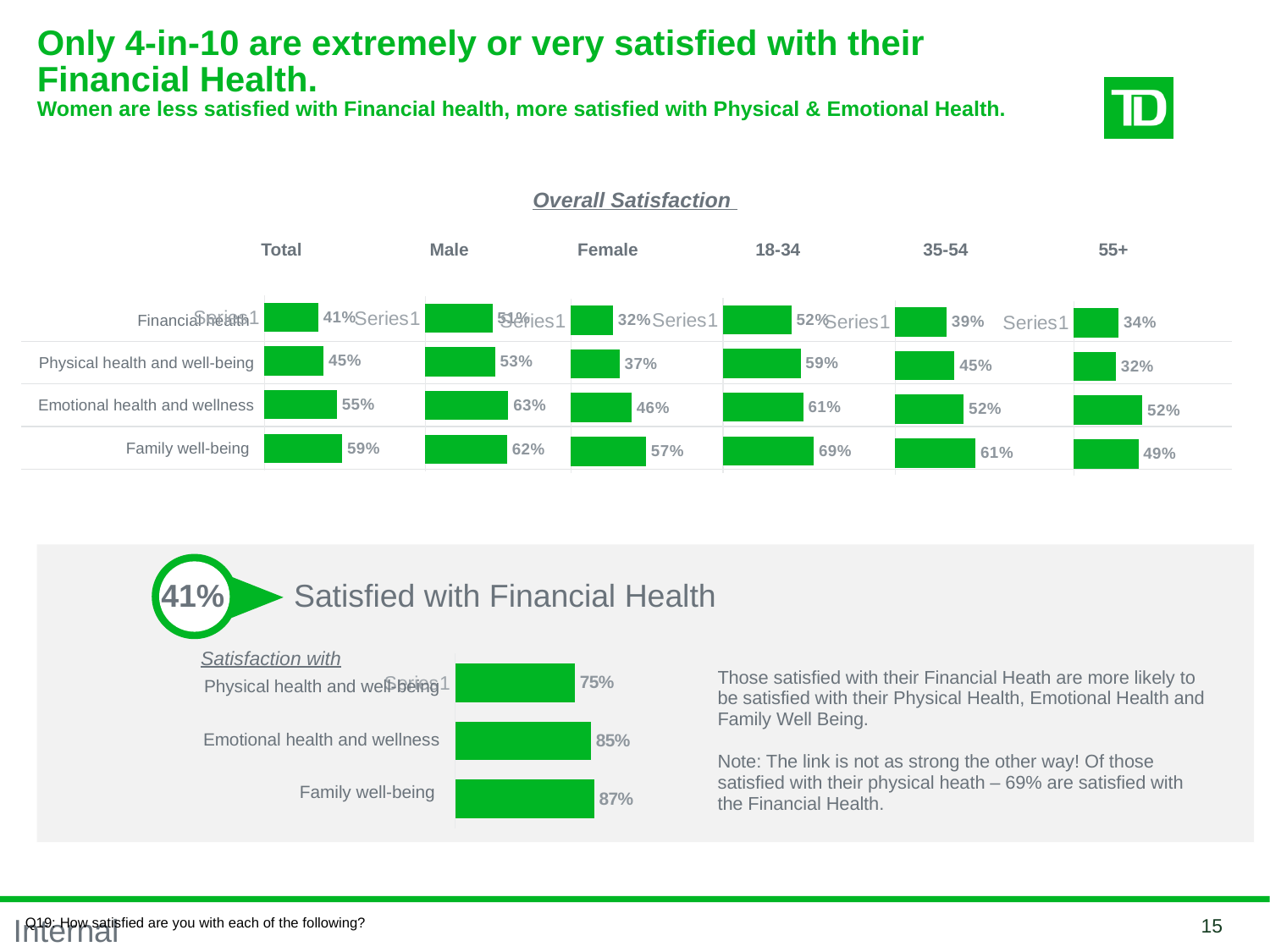
What type of chart is the bottom 'Satisfaction with' chart? Bar chart In the Overall Satisfaction 35-54 chart, what is the value for Family well-being? 61% In the Overall Satisfaction Total chart, what is the value for Financial health? 41% In the bottom 'Satisfaction with' chart, what is the difference between Emotional health and wellness and Physical health and well-being? 10% What is the title of the chart section at the top of the slide? Overall Satisfaction In the Overall Satisfaction Female chart, what is the value for Emotional health and wellness? 46% In the Overall Satisfaction 18-34 chart, which category has the highest value? Family well-being In the Overall Satisfaction 55+ chart, which category has the lowest value? Physical health and well-being How many categories are shown in each Overall Satisfaction chart? 4 In the Overall Satisfaction charts, is the Financial health value larger for Male or for Female? Male In the bottom 'Satisfaction with' chart, what is the value for Family well-being? 87% In the Overall Satisfaction Male chart, what is the difference between Emotional health and wellness and Financial health? 12%